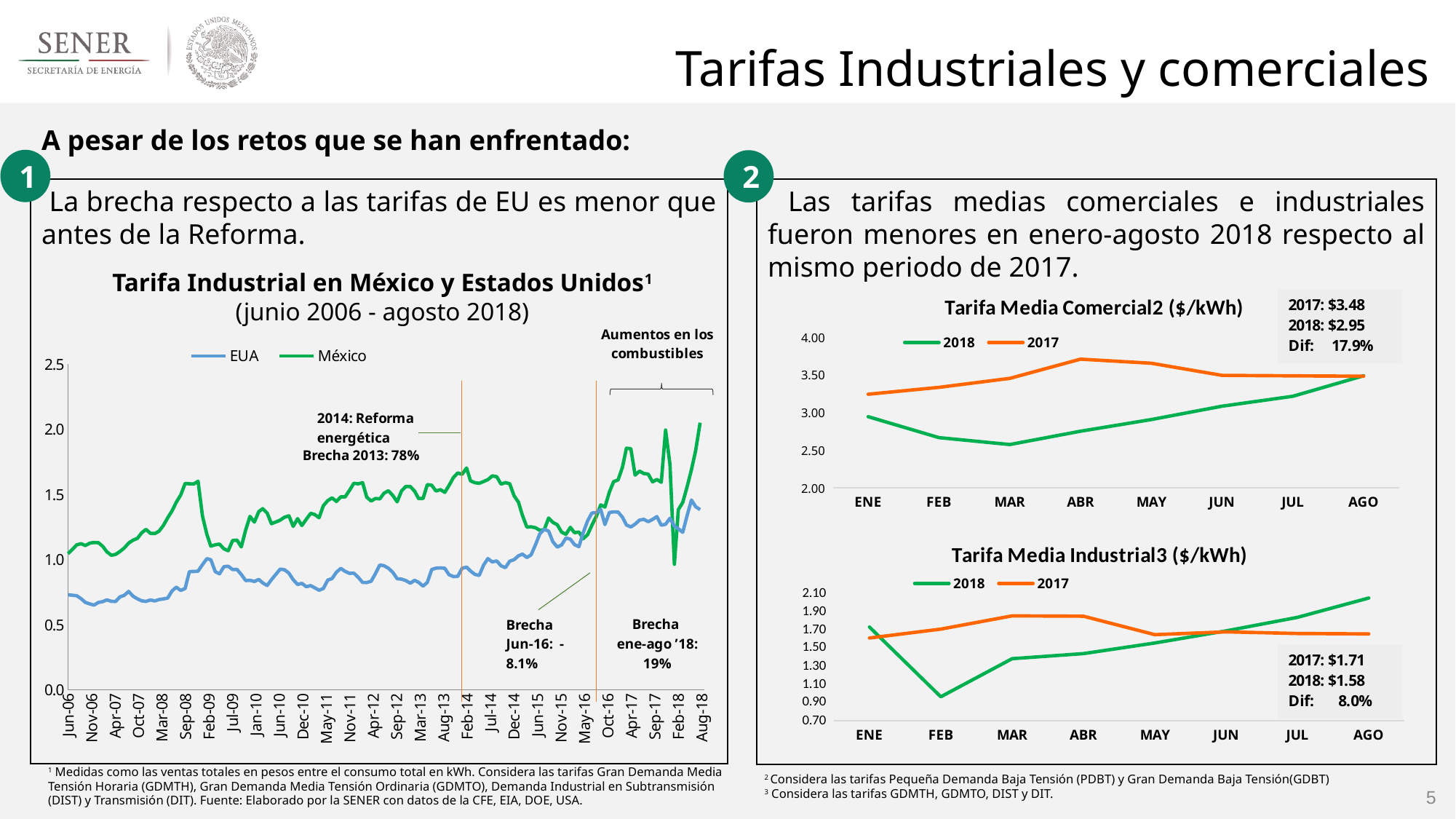
In 'Tarifa Industrial en México y Estados Unidos', is the value for EUA at Jun-06 greater or less than 1.0? less In 'Tarifa Media Comercial2 ($/kWh)', is the value for 2018 in FEB greater or less than 3.00? less In 'Tarifa Media Industrial3 ($/kWh)', which month has the lowest value for 2018? FEB In 'Tarifa Media Comercial2 ($/kWh)', what is the 2018 average value shown in the annotation box? $2.95 In 'Tarifa Media Comercial2 ($/kWh)', which month has the highest value for 2017? ABR In 'Tarifa Industrial en México y Estados Unidos', is the value for México at Aug-18 greater or less than 1.5? greater What type of chart is 'Tarifa Industrial en México y Estados Unidos'? line chart In 'Tarifa Media Industrial3 ($/kWh)', which series has the larger value in AGO, 2018 or 2017? 2018 In 'Tarifa Media Industrial3 ($/kWh)', what is the Dif value shown in the annotation box? 8.0% In 'Tarifa Industrial en México y Estados Unidos', what is the Brecha for ene-ago '18 shown in the annotation? 19% In 'Tarifa Media Comercial2 ($/kWh)', how many months are plotted on the x axis? 8 How many series does the legend of 'Tarifa Industrial en México y Estados Unidos' list? 2